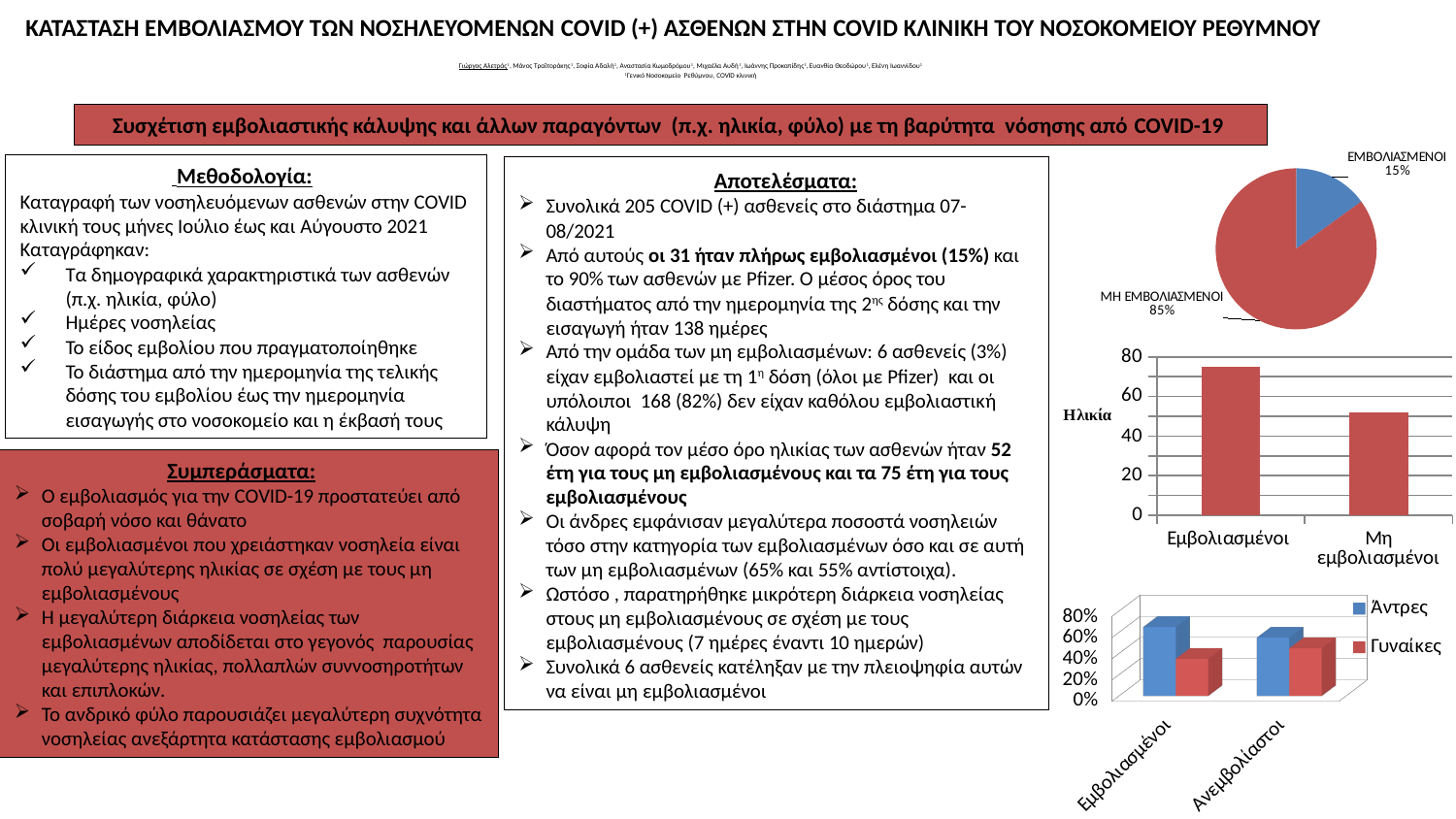
In the pie chart at the top right, what is the difference in percentage points between the ΜΗ ΕΜΒΟΛΙΑΣΜΕΝΟΙ and ΕΜΒΟΛΙΑΣΜΕΝΟΙ slices? 70 percentage points What type of chart is the Ηλικία chart in the middle right? Bar chart In the bottom-right bar chart, which series has the taller bar for Εμβολιασμένοι, Άντρες or Γυναίκες? Άντρες How many slices does the pie chart at the top right have? 2 In the pie chart at the top right, what percentage is shown for ΕΜΒΟΛΙΑΣΜΕΝΟΙ? 15% In the pie chart at the top right, what percentage is shown for ΜΗ ΕΜΒΟΛΙΑΣΜΕΝΟΙ? 85% In the Ηλικία bar chart, is the value for Μη εμβολιασμένοι greater or less than 60? less In the Ηλικία bar chart, which category has the higher bar? Εμβολιασμένοι How many series does the legend of the bottom-right bar chart list? 2 In the Ηλικία bar chart, is the value for Εμβολιασμένοι greater or less than 60? greater In the pie chart at the top right, which slice is the largest? ΜΗ ΕΜΒΟΛΙΑΣΜΕΝΟΙ In the bottom-right bar chart, what colour are the Γυναίκες bars? Red